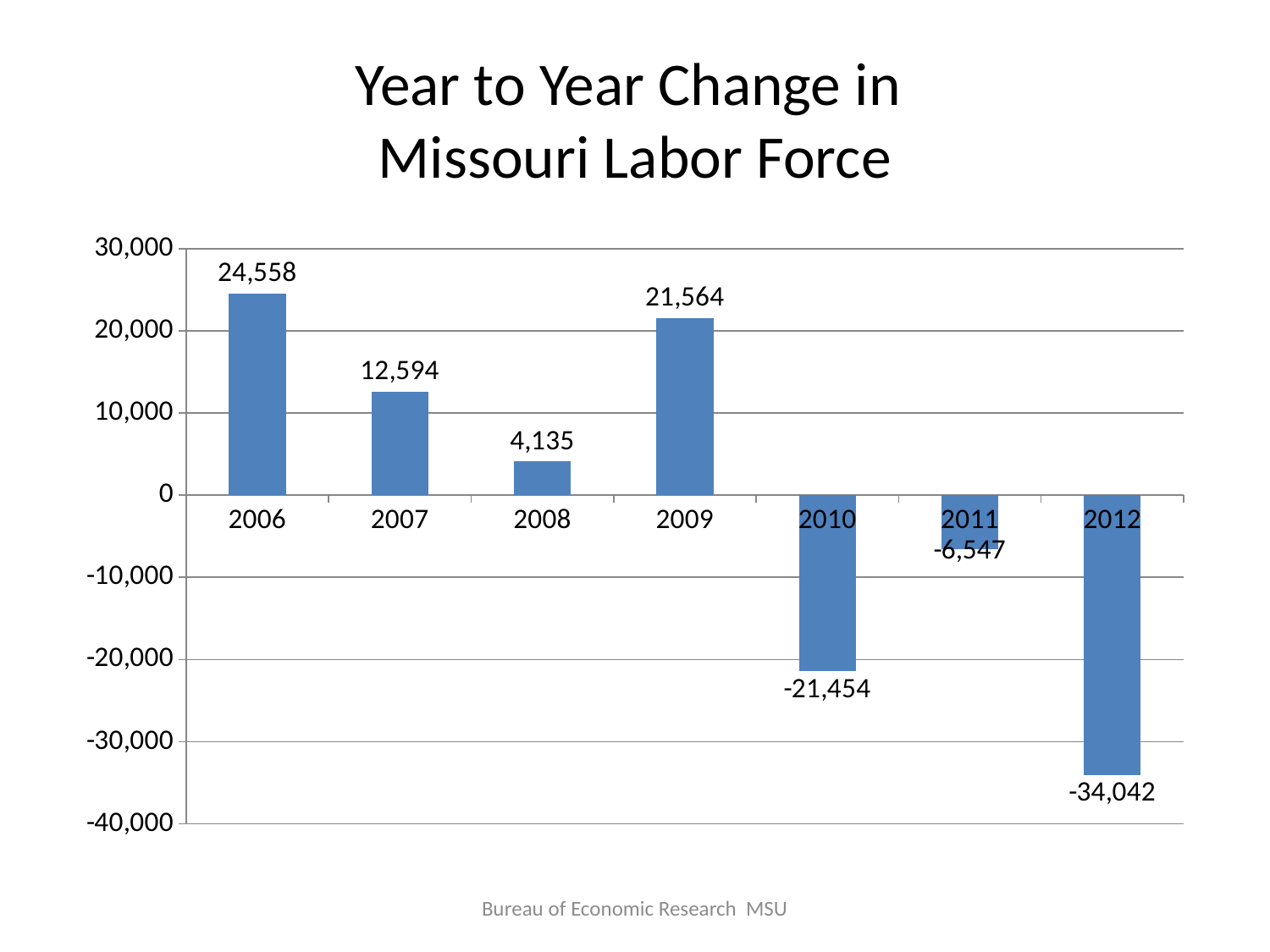
What is the difference between the values for 2006 and 2009? 2,994 What kind of chart is shown on the slide? Bar chart What is the value shown for 2008? 4,135 Which year has the larger value, 2007 or 2009? 2009 What is the title of the chart? Year to Year Change in Missouri Labor Force What is the year to year change in Missouri labor force for 2006? 24,558 Which year has the highest year to year change? 2006 Is the value for 2011 greater or less than -10,000? greater Do the values rise or fall from 2009 to 2012? Fall How many years are shown on the chart? 7 What is the value shown for 2010? -21,454 Which year has the lowest year to year change? 2012